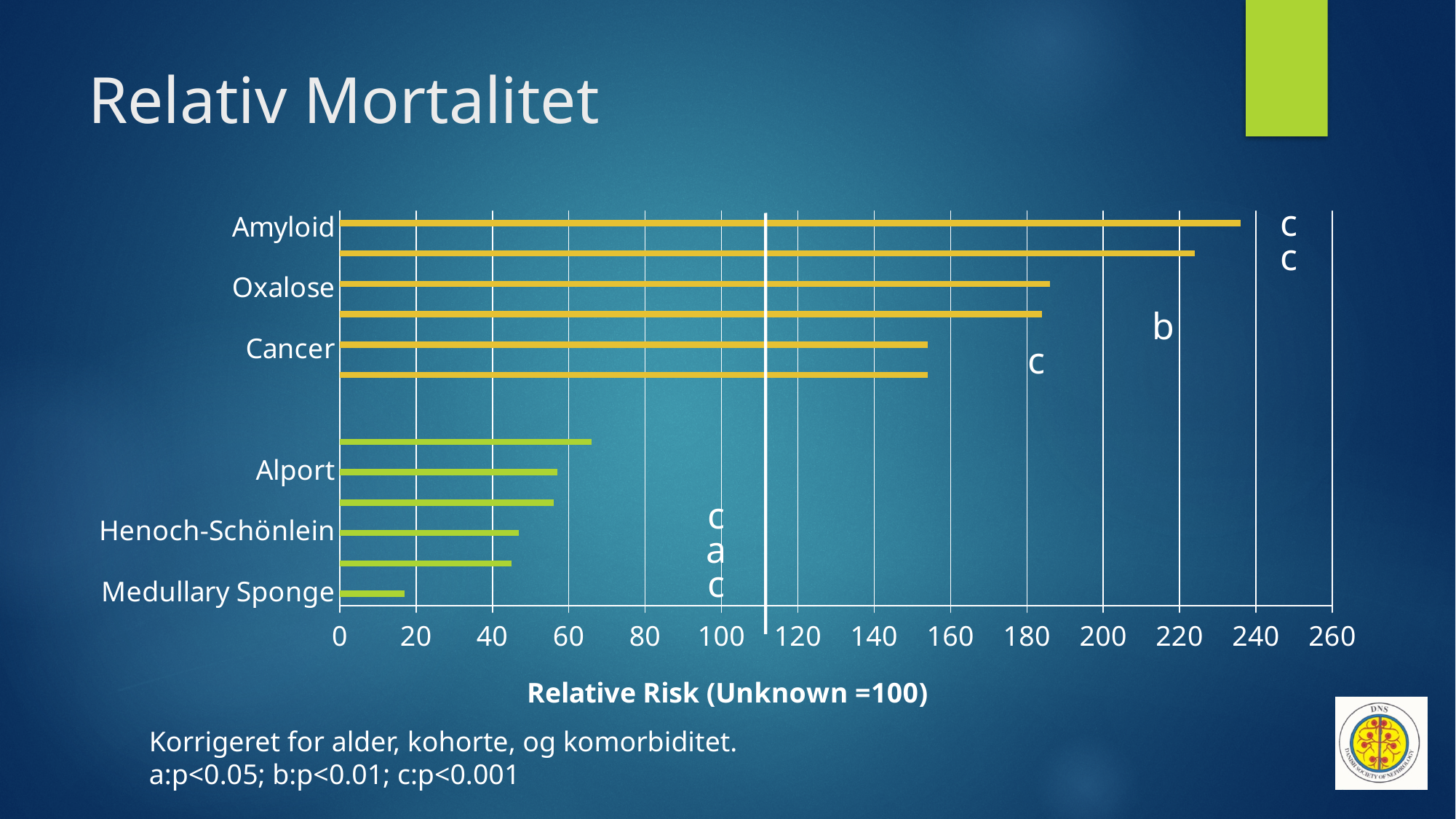
Is the value for Oxalose greater or less than 160? greater Is the value for Alport greater or less than 80? less Is the value for Cancer greater or less than 140? greater Which labeled category has the lowest relative risk? Medullary Sponge Which labeled category has the highest relative risk? Amyloid Which has the larger relative risk, Cancer or Alport? Cancer Which has the larger relative risk, Amyloid or Oxalose? Amyloid What is the title of the x axis? Relative Risk (Unknown =100) What kind of chart is shown on the slide? bar chart